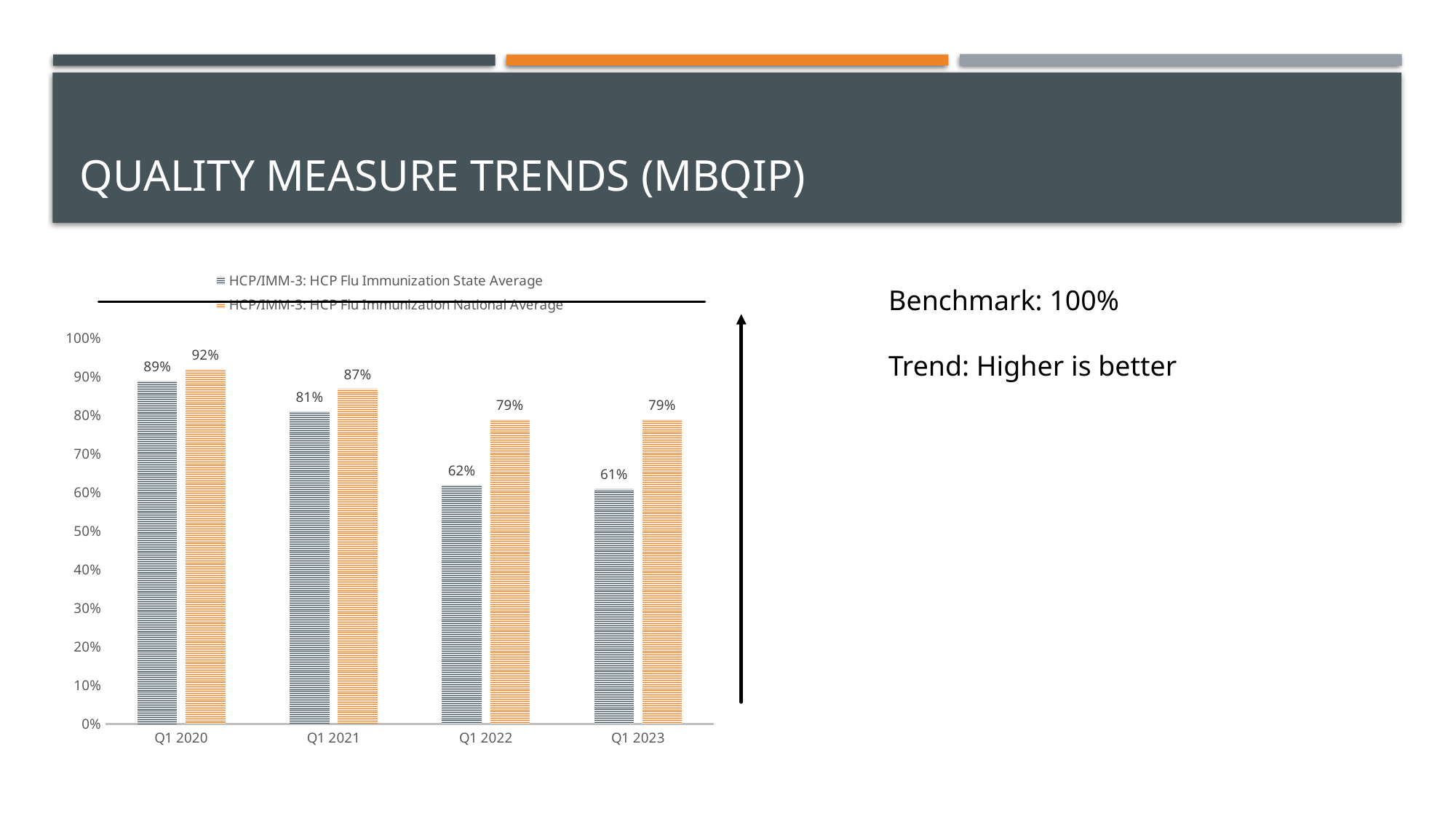
Which is larger in Q1 2020, the State Average or the National Average? National Average What is the difference between the National Average and the State Average in Q1 2022? 17% Does the HCP Flu Immunization State Average rise or fall from Q1 2020 to Q1 2023? Fall How many series does the legend list? 2 What is the HCP Flu Immunization State Average for Q1 2023? 61% What is the HCP Flu Immunization State Average for Q1 2020? 89% What benchmark value is stated on the slide? 100% What is the HCP Flu Immunization National Average for Q1 2021? 87% What kind of chart is shown on the slide? Bar chart How many quarters are shown on the x axis? 4 In which quarter is the HCP Flu Immunization State Average lowest? Q1 2023 In which quarter is the HCP Flu Immunization State Average highest? Q1 2020